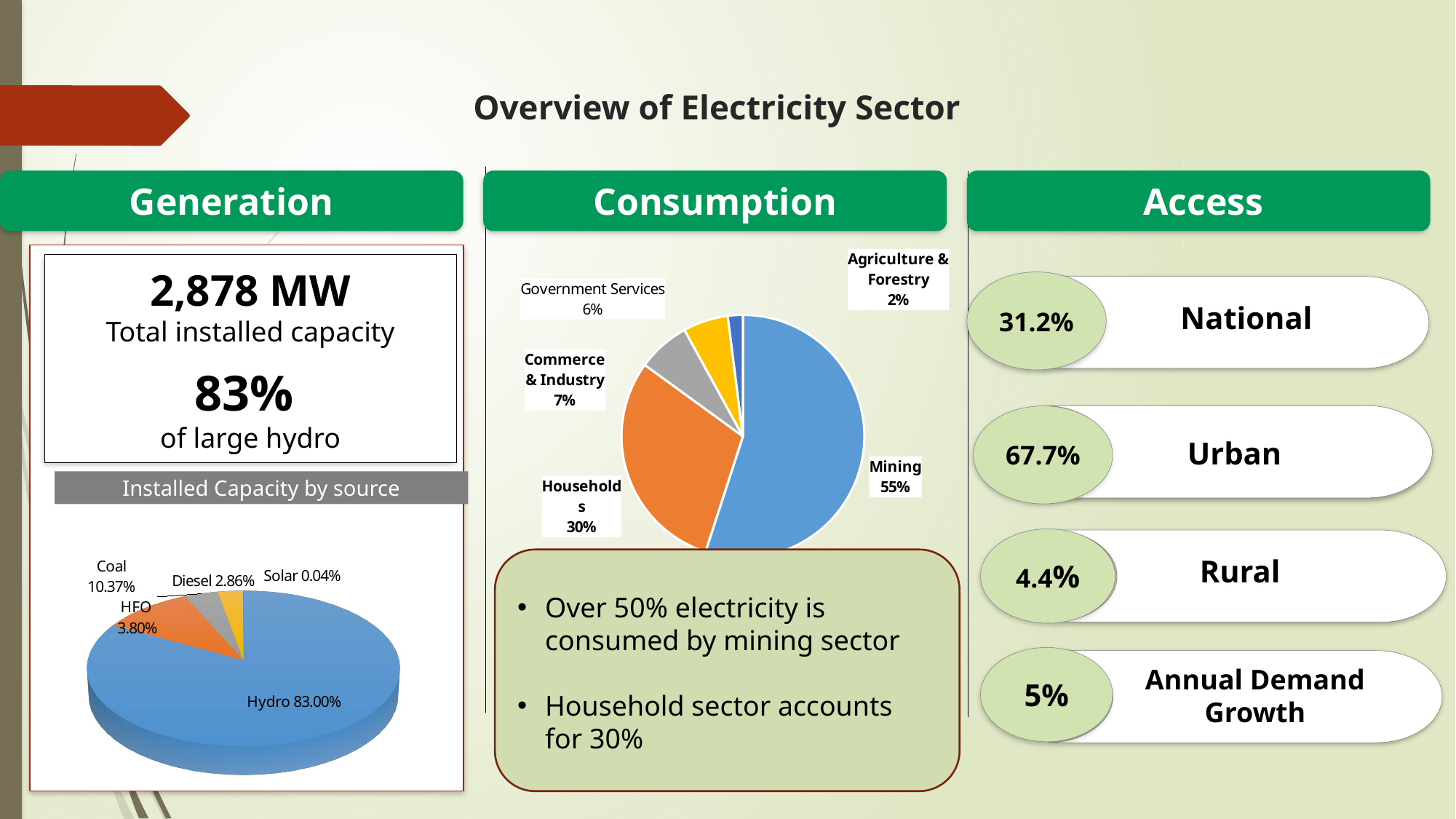
In the Consumption pie chart, which sector has the largest share? Mining In the Installed Capacity by source chart, how many sources are shown? 5 What kind of chart is the Installed Capacity by source chart? Pie chart In the Consumption pie chart, what is the difference between the Mining and Households shares? 25% In the Installed Capacity by source chart, what share does Hydro have? 83.00% In the Consumption pie chart, what is the value for Government Services? 6% In the Installed Capacity by source chart, what is the difference between the Coal and HFO shares? 6.57% In the Consumption pie chart, which is larger: Commerce & Industry or Agriculture & Forestry? Commerce & Industry In the Consumption pie chart, what share is consumed by Mining? 55% In the Installed Capacity by source chart, what is the value for Coal? 10.37% In the Consumption pie chart, how many sectors are shown? 5 In the Installed Capacity by source chart, which source has the smallest share? Solar